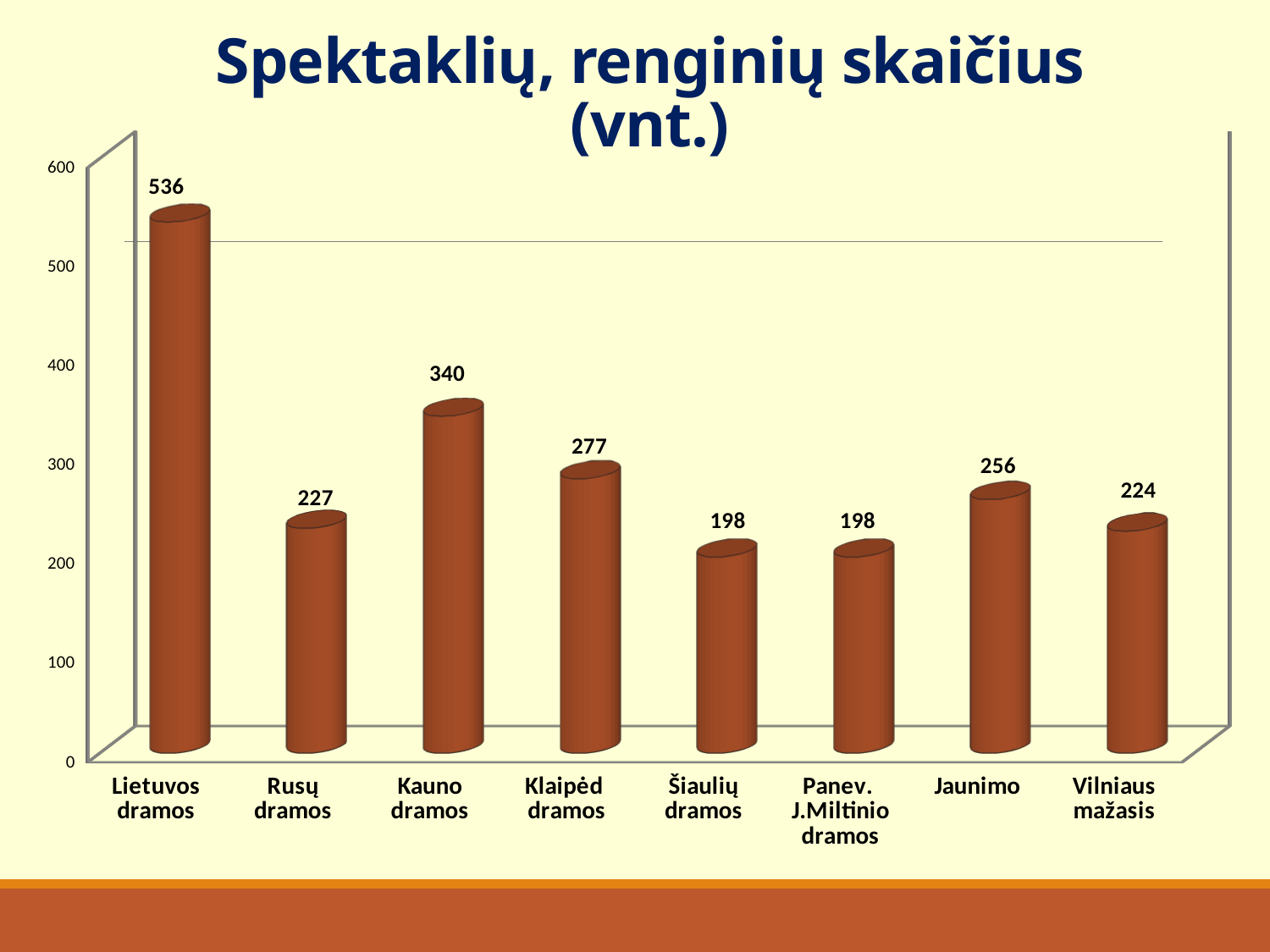
What is the value for Jaunimo? 256 What is the difference between the values for Klaipėd dramos and Rusų dramos? 50 How many categories are shown on the x axis? 8 Is the value for Kauno dramos greater or less than 300? greater What is the value for Kauno dramos? 340 What is the difference between the values for Lietuvos dramos and Kauno dramos? 196 Which is larger, the value for Jaunimo or the value for Vilniaus mažasis? Jaunimo What is the value for Vilniaus mažasis? 224 What is the value for Lietuvos dramos? 536 What kind of chart is shown on the slide? bar chart Which category has the highest value? Lietuvos dramos What is the title of the chart? Spektaklių, renginių skaičius (vnt.)